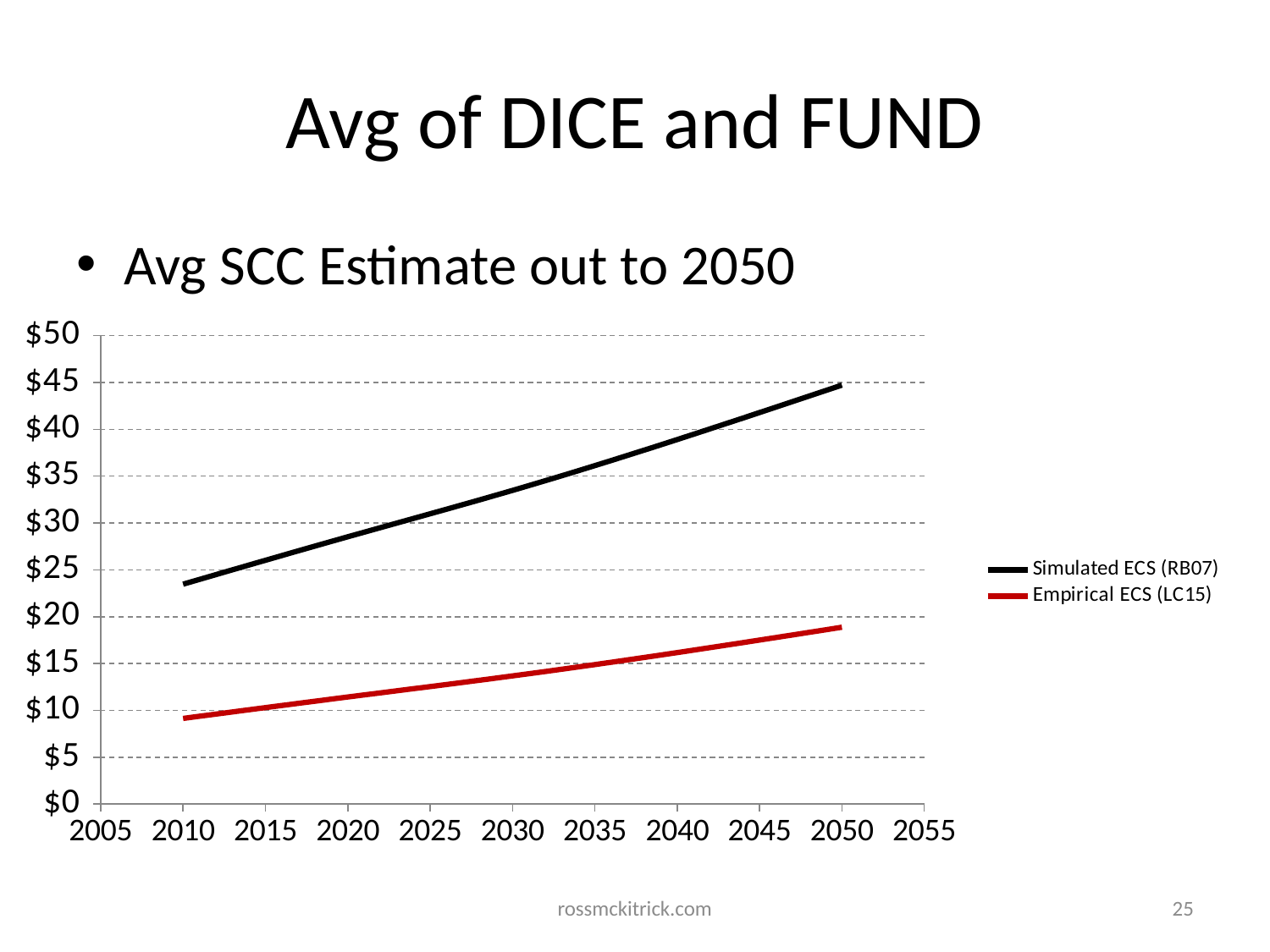
Does the Empirical ECS (LC15) line rise or fall from 2010 to 2050? rise Is the value for Empirical ECS (LC15) in 2010 greater or less than $10? less What is the title of the slide containing the chart? Avg of DICE and FUND What colour is the Empirical ECS (LC15) line? red Is the value for Simulated ECS (RB07) in 2050 greater or less than $40? greater Is the value for Simulated ECS (RB07) in 2030 greater or less than $30? greater How many series does the legend list? 2 Does the Simulated ECS (RB07) line rise or fall from 2010 to 2050? rise What kind of chart is shown on the slide? line chart Which series has the higher value in 2050, Simulated ECS (RB07) or Empirical ECS (LC15)? Simulated ECS (RB07)